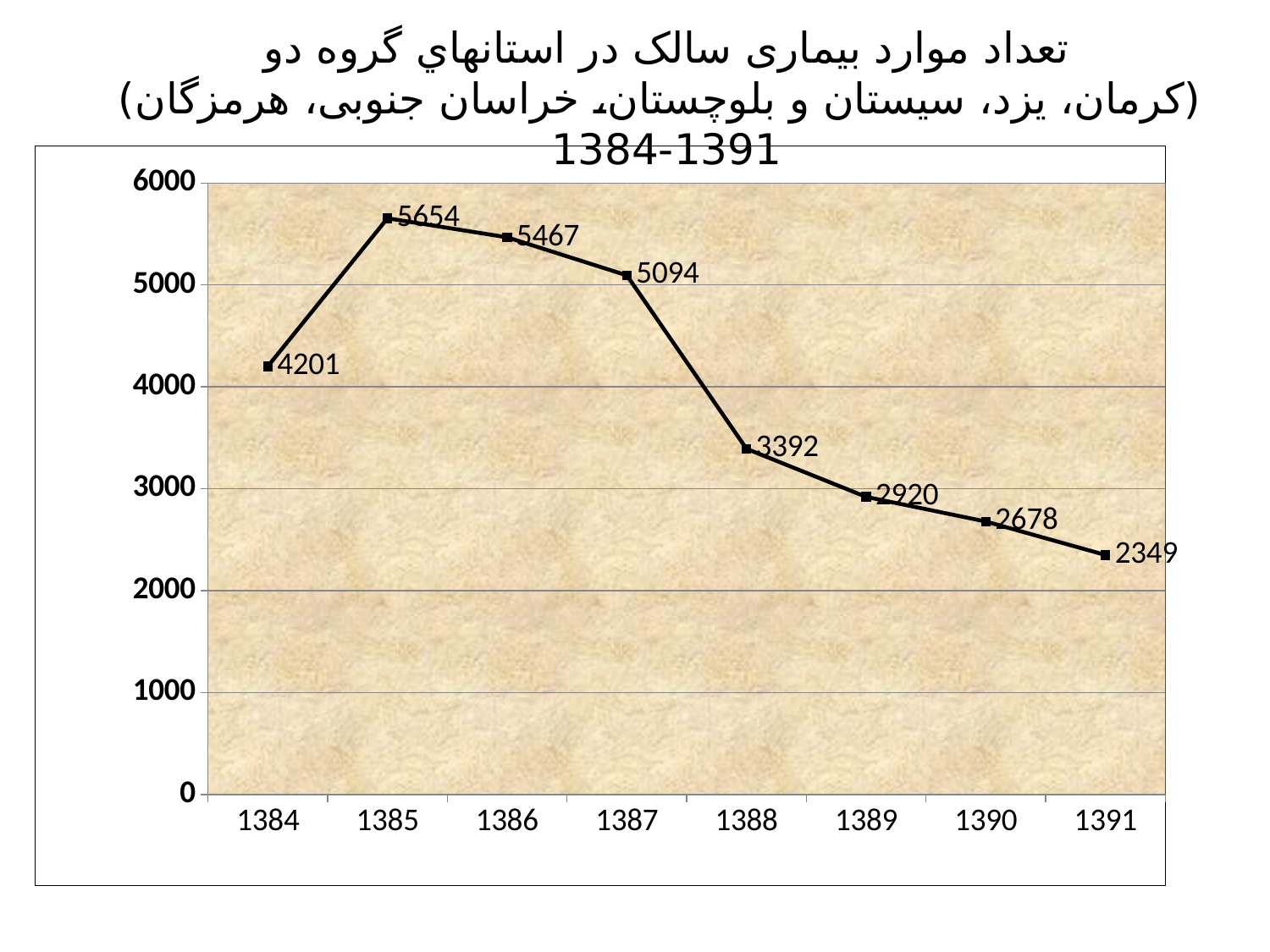
What is the value for 1391? 2349 Which year has the lowest value? 1391 How many years are plotted on the chart? 8 What kind of chart is shown on the slide? line chart What is the value for 1388? 3392 Which year has the highest value? 1385 What is the difference between the values for 1385 and 1384? 1453 What is the value for 1385? 5654 Which is larger, the value for 1386 or the value for 1389? 1386 Is the value for 1390 greater or less than 3000? less What is the difference between the values for 1387 and 1388? 1702 Do the values rise or fall from 1387 to 1391? fall